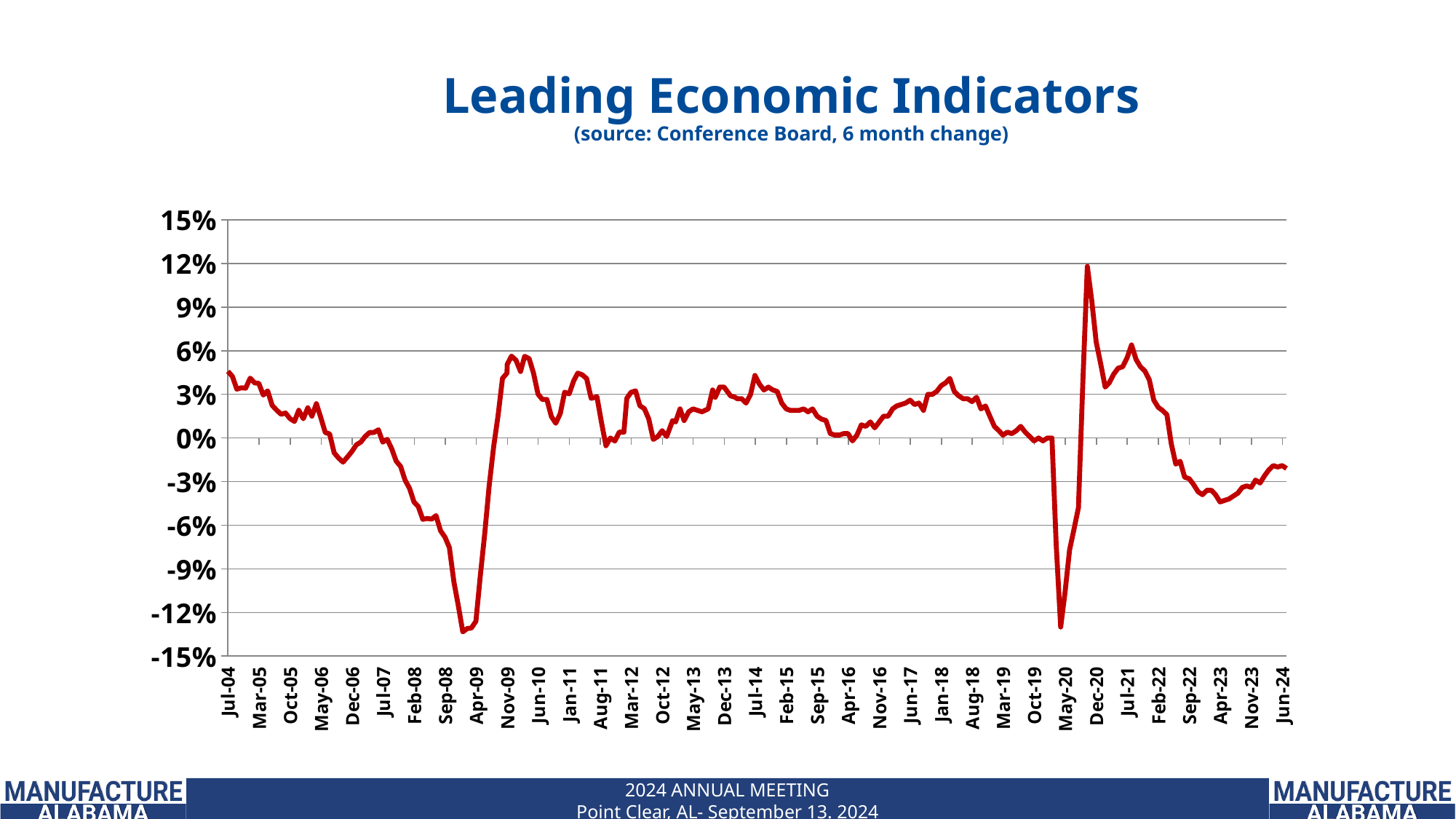
According to the subtitle, what is the source of the data in the chart? Conference Board Is the value for Jun-24 greater or less than -3%? greater Between Jul-21 and Sep-22, does the line generally rise or fall? fall Is the value for May-20 greater or less than -9%? less Is the value for Jul-14 greater or less than 0%? greater Around which x-axis label does the line reach its highest value? Dec-20 What is the title of the chart? Leading Economic Indicators How many data series are plotted in the chart? 1 What kind of chart is shown on the slide? line chart